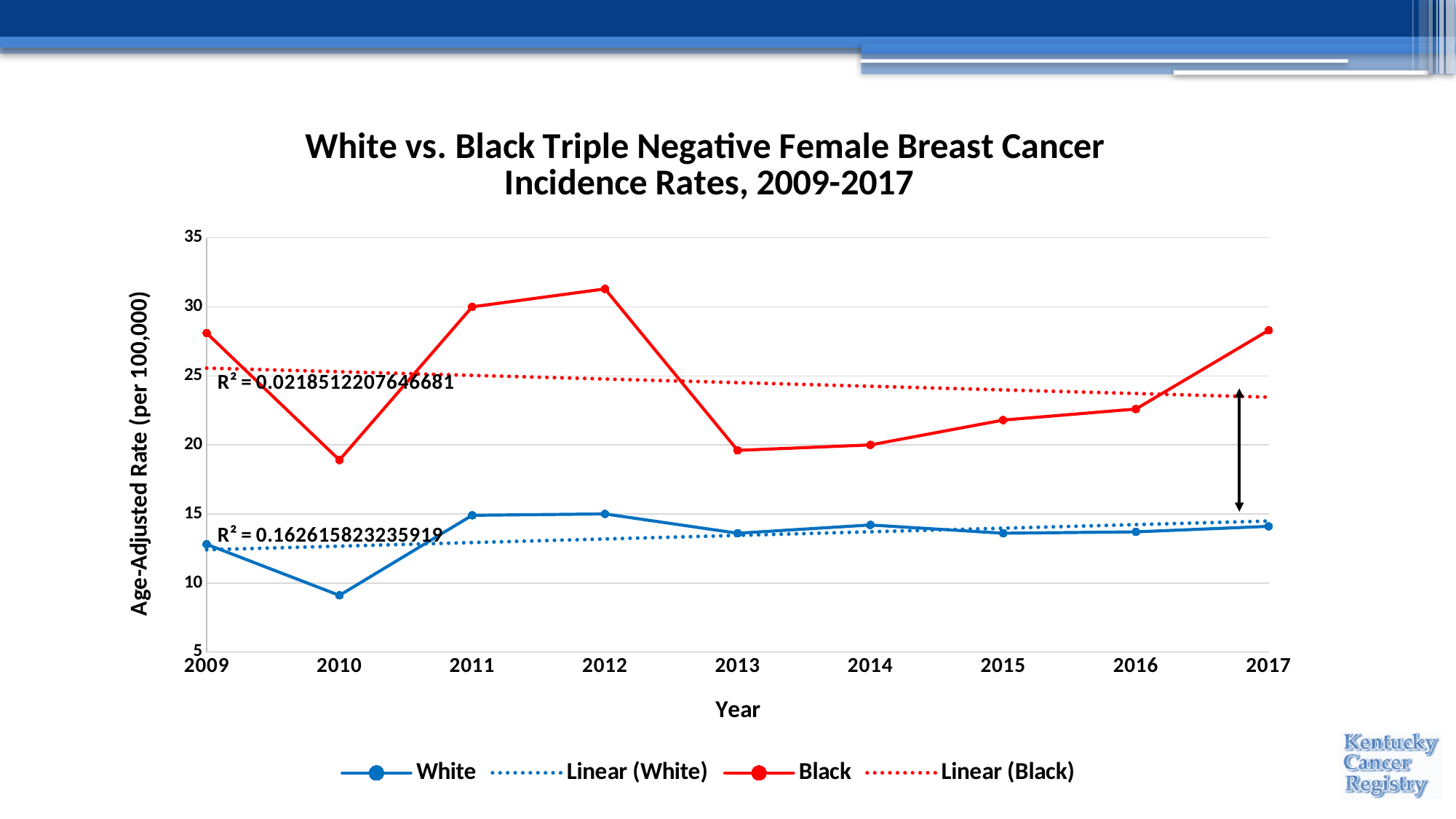
In which year is the White incidence rate lowest? 2010 How many years are plotted along the x axis? 9 In which year is the Black incidence rate lowest? 2010 How many entries does the legend list? 4 In 2013, which series has the higher rate, White or Black? Black In which year is the Black incidence rate highest? 2012 What R² value is shown for the Black trendline? 0.0218512207646681 What kind of chart is shown on the slide? line chart Does the dotted Linear (Black) trendline rise or fall from 2009 to 2017? fall Is the Black rate in 2009 greater or less than 25? greater Is the White rate in 2010 greater or less than 10? less Is the Black rate in 2016 greater or less than 20? greater